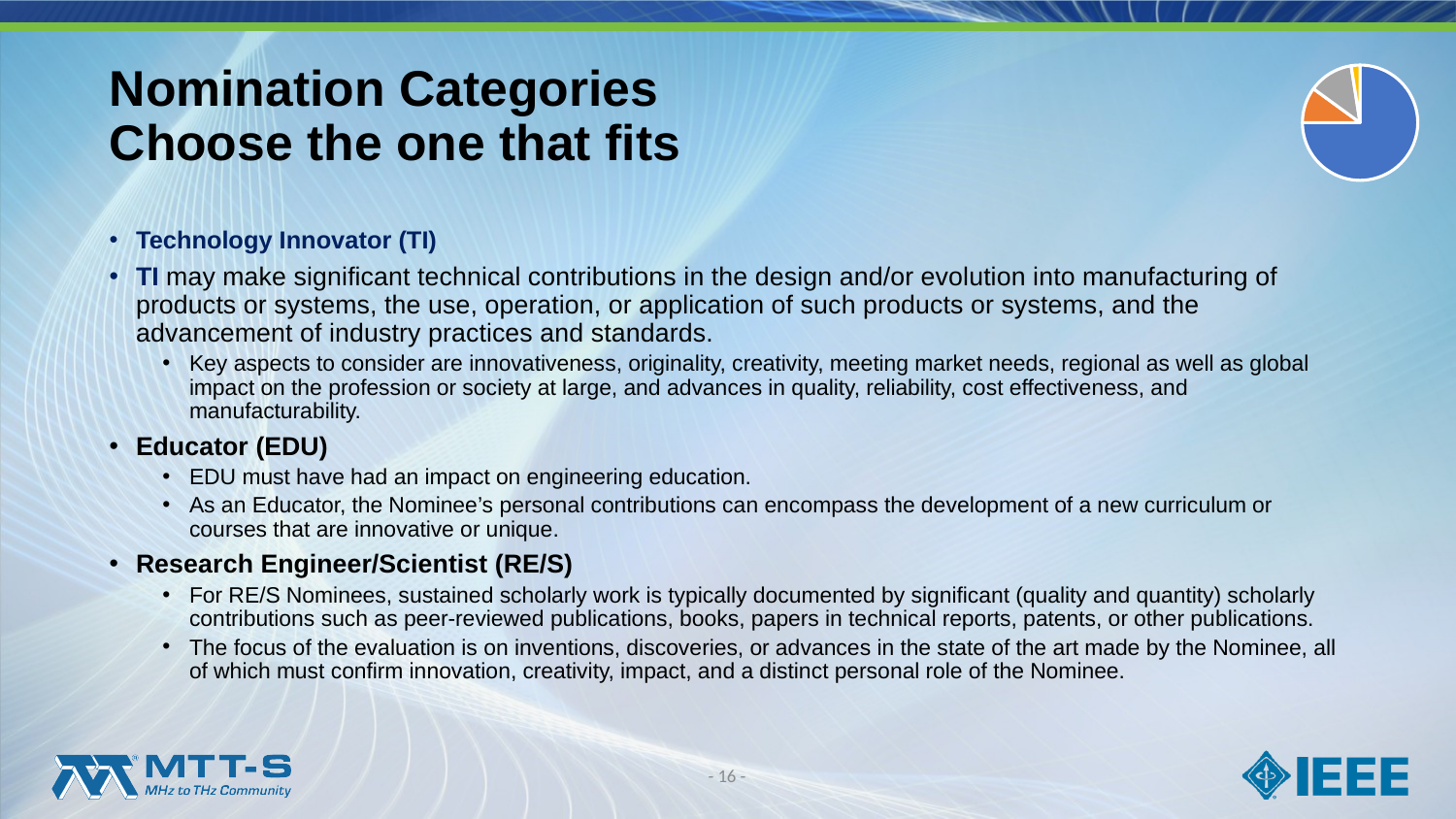
Which colour slice is the largest in the pie chart in the top right corner? blue How many slices does the pie chart in the top right corner have? 4 In the pie chart in the top right corner, is the blue slice larger or smaller than the orange slice? larger What kind of chart is shown in the top right corner of the slide? pie chart In the pie chart in the top right corner, is the gray slice larger or smaller than the blue slice? smaller Does the pie chart in the top right corner show a legend? No